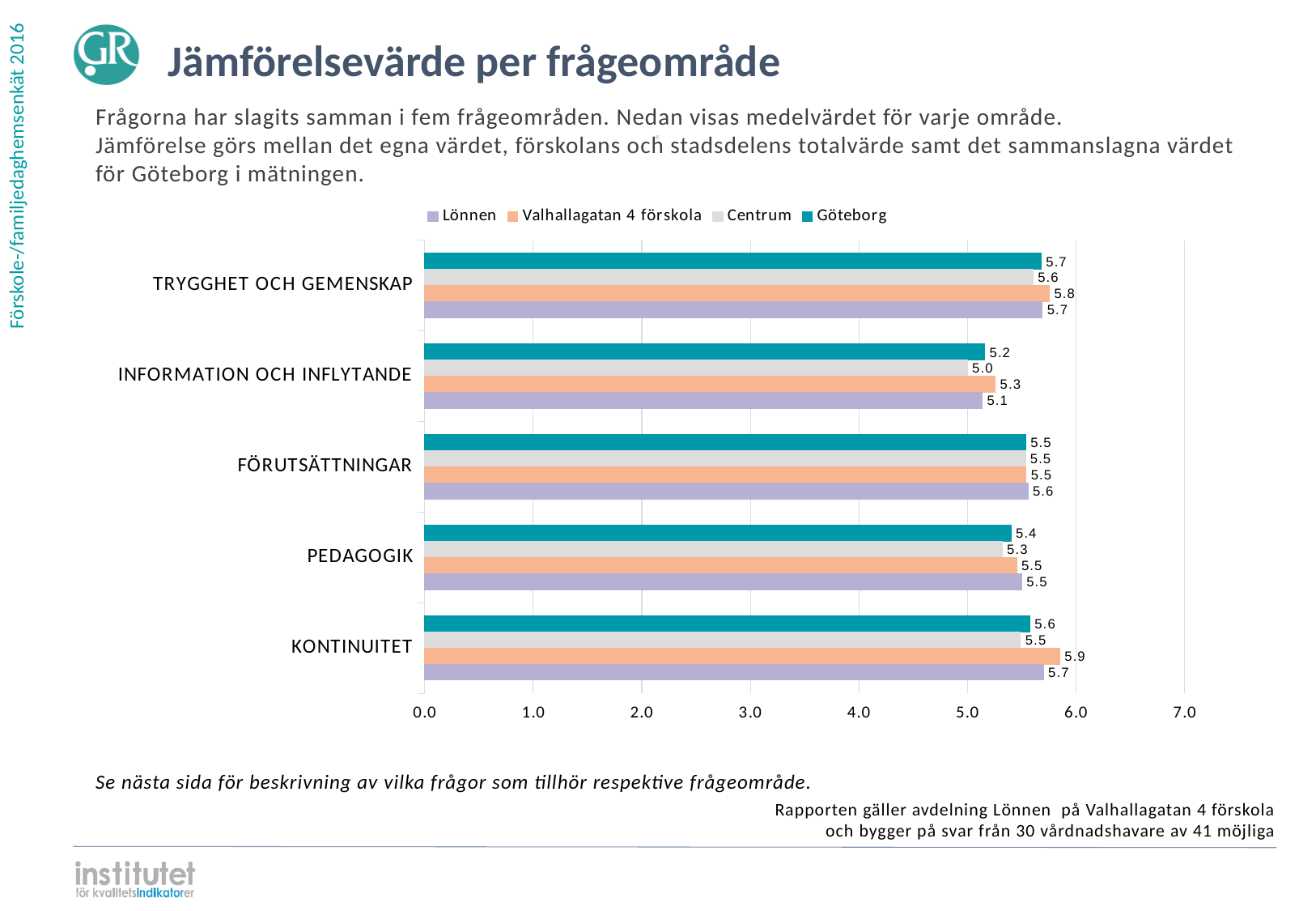
What is the value for Centrum in the INFORMATION OCH INFLYTANDE category? 5.0 How many series does the legend list? 4 What is the value for Lönnen in the TRYGGHET OCH GEMENSKAP category? 5.7 What is the value for Valhallagatan 4 förskola in the KONTINUITET category? 5.9 Which category has the highest value for Valhallagatan 4 förskola? KONTINUITET How many categories are shown on the chart? 5 Which series is shown in teal in the legend? Göteborg Which category has the lowest value for Lönnen? INFORMATION OCH INFLYTANDE What is the value for Göteborg in the PEDAGOGIK category? 5.4 What is the difference between the Valhallagatan 4 förskola value and the Centrum value in the KONTINUITET category? 0.4 In the INFORMATION OCH INFLYTANDE category, which is larger: the value for Valhallagatan 4 förskola or the value for Lönnen? Valhallagatan 4 förskola What kind of chart is shown on the slide? Bar chart